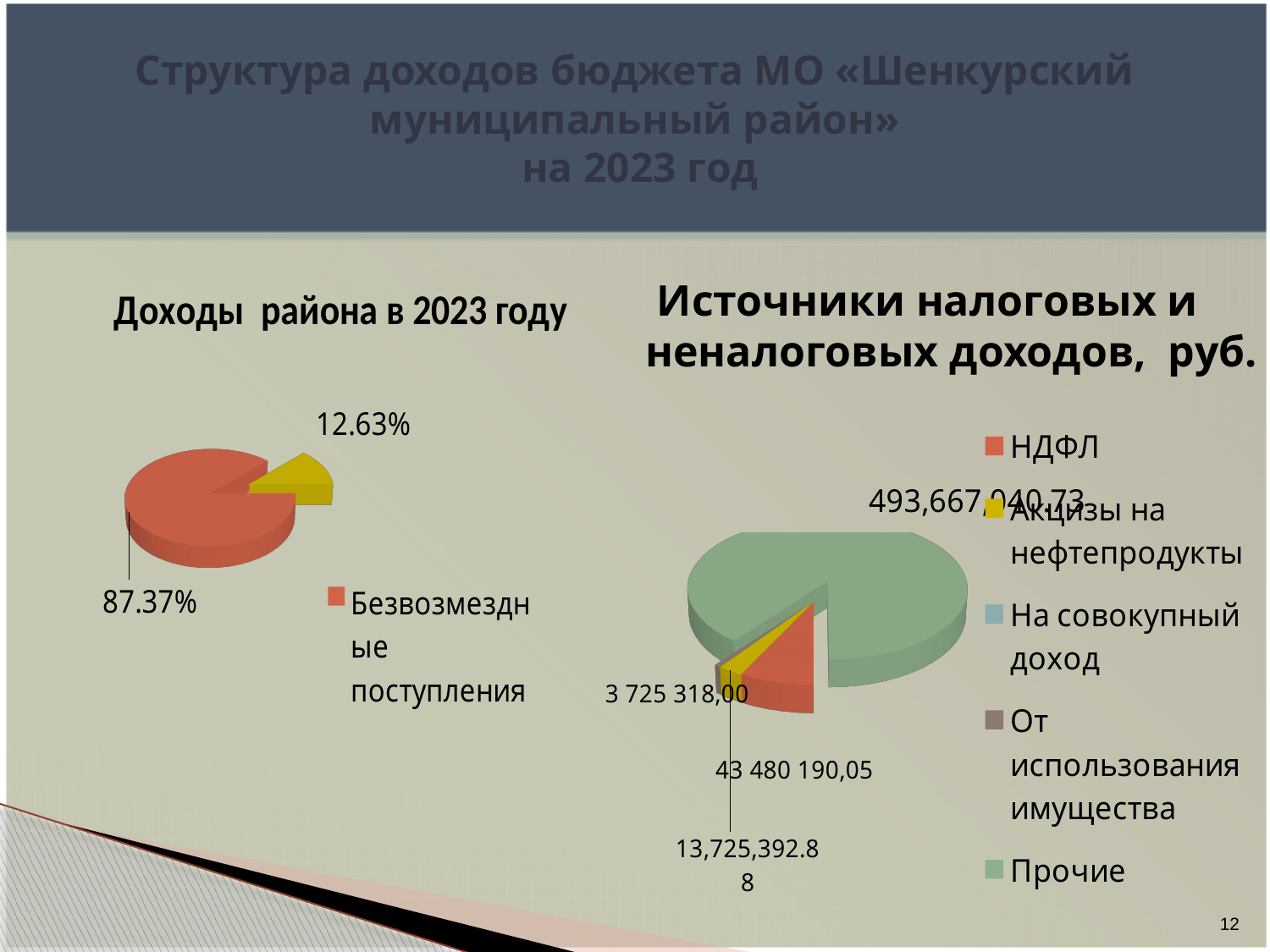
In the left chart "Доходы района в 2023 году", which slice is the largest? Безвозмездные поступления In the right chart "Источники налоговых и неналоговых доходов, руб.", which is larger: НДФЛ or От использования имущества? НДФЛ In the right chart "Источники налоговых и неналоговых доходов, руб.", what value is shown for От использования имущества? 3 725 318,00 What kind of chart is the right chart "Источники налоговых и неналоговых доходов, руб."? pie chart What kind of chart is the left chart titled "Доходы района в 2023 году"? pie chart In the right chart "Источники налоговых и неналоговых доходов, руб.", what colour represents Прочие in the legend? green In the right chart "Источники налоговых и неналоговых доходов, руб.", which category has the largest slice? Прочие How many entries does the legend of the right chart "Источники налоговых и неналоговых доходов, руб." list? 5 In the left chart "Доходы района в 2023 году", what share is shown for Безвозмездные поступления? 87.37% In the left chart "Доходы района в 2023 году", what is the value of the smaller slice? 12.63% How many slices does the left chart "Доходы района в 2023 году" have? 2 In the right chart "Источники налоговых и неналоговых доходов, руб.", what value is shown for НДФЛ? 43 480 190,05